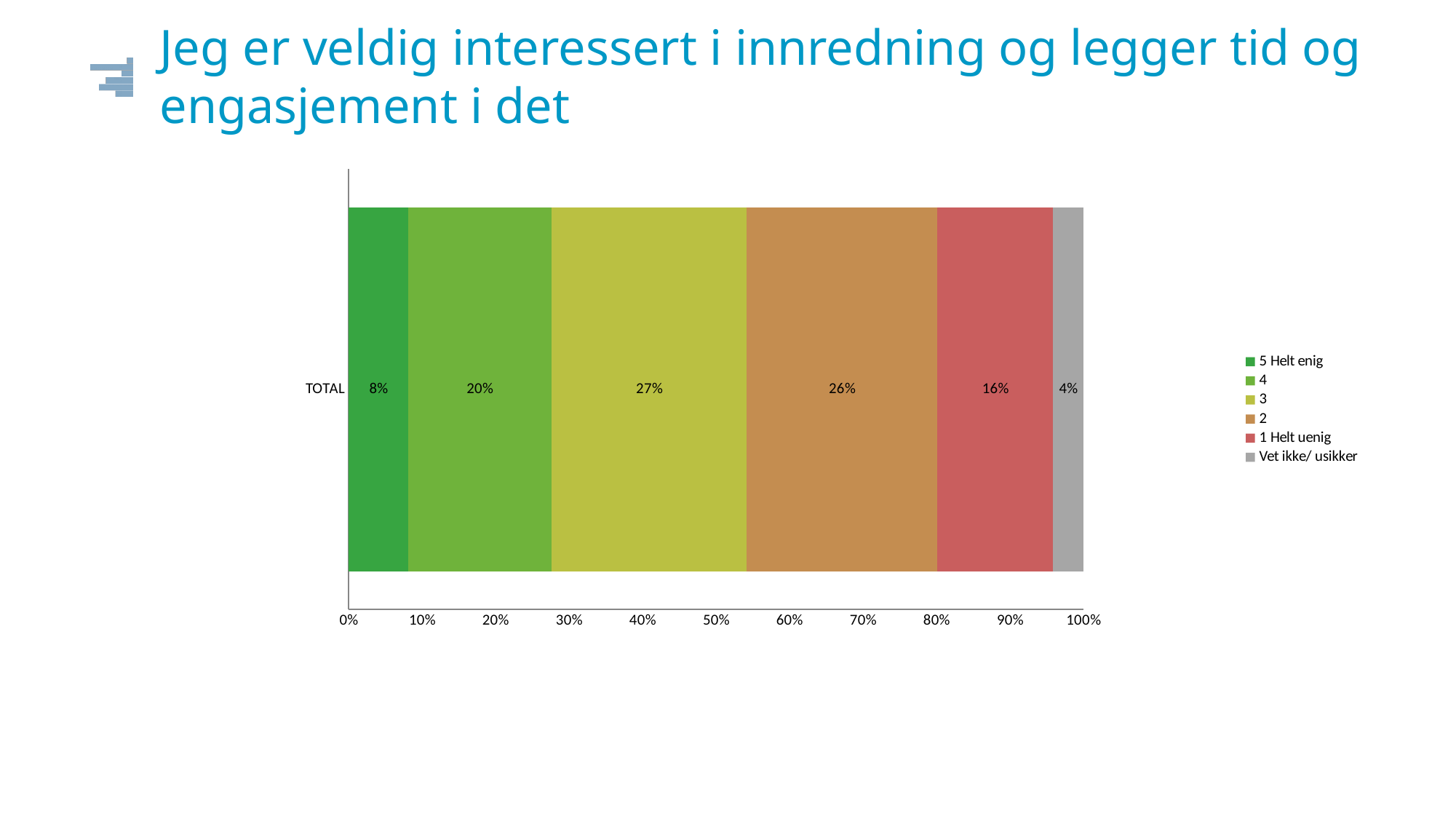
What is the value for the "3" segment of the TOTAL bar? 27% What is the label of the single category on the vertical axis? TOTAL What kind of chart is shown on the slide? Stacked bar chart What is the value for "Vet ikke/ usikker"? 4% Which response category has the largest share in the TOTAL bar? 3 What percentage of respondents answered "5 Helt enig"? 8% How many series does the legend list? 6 Which response category has the smallest share in the TOTAL bar? Vet ikke/ usikker Which is larger, the share for "2" or the share for "1 Helt uenig"? 2 What is the difference between the share for "4" and the share for "5 Helt enig"? 12% What is the combined share of "5 Helt enig" and "4"? 28% What share of respondents answered "1 Helt uenig"? 16%